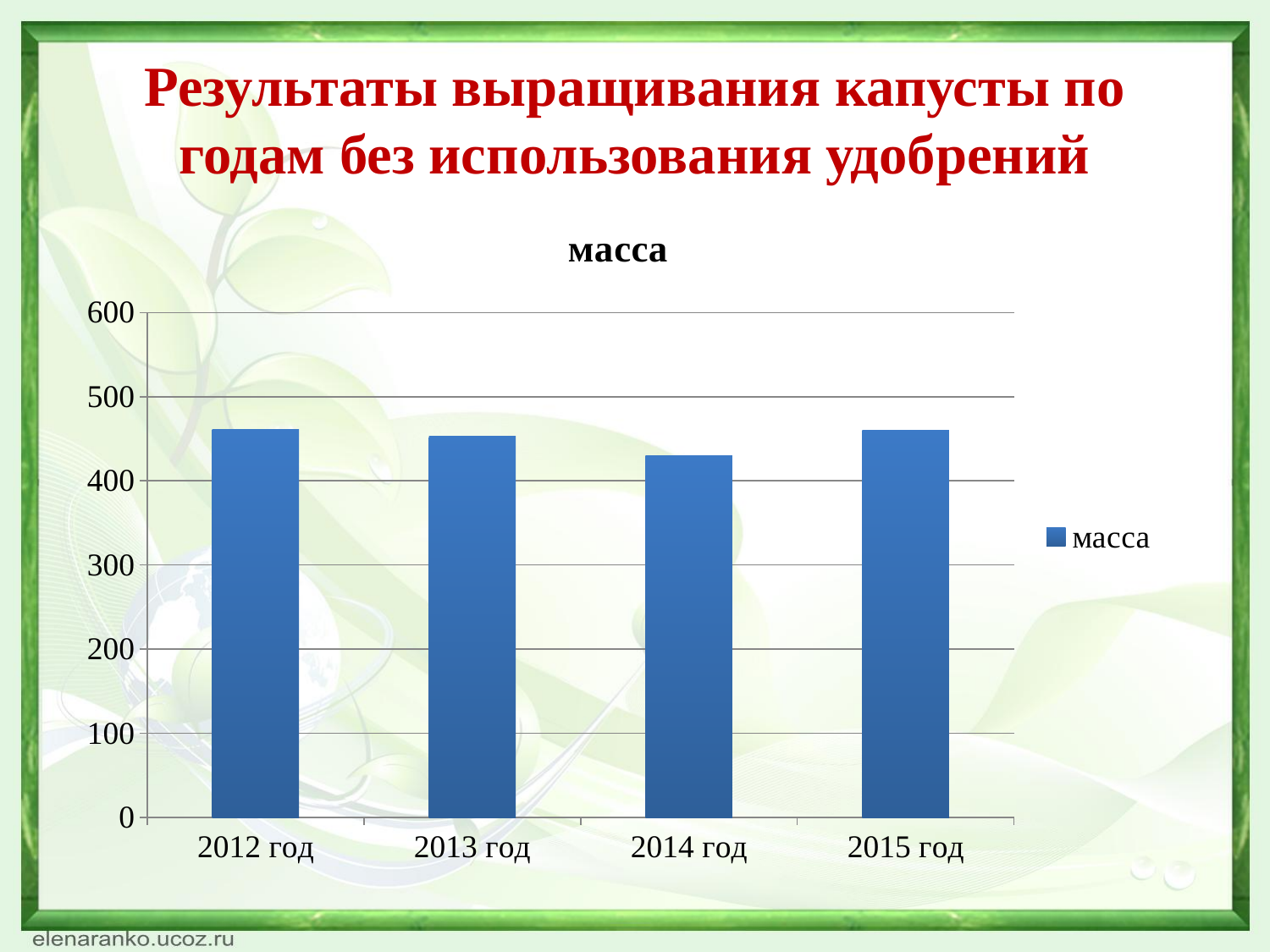
Do the values rise or fall from 2012 год to 2014 год? fall Is the value for 2014 год greater or less than 500? less Is the value for 2012 год greater or less than 500? less Which year has the lowest value? 2014 год How many categories (years) are shown on the x axis? 4 Is the value for 2015 год greater or less than 400? greater What kind of chart is shown on the slide? bar chart How many series does the legend list? 1 Which is larger, the value for 2012 год or the value for 2014 год? 2012 год What is the title of the chart? масса Which is larger, the value for 2013 год or the value for 2014 год? 2013 год